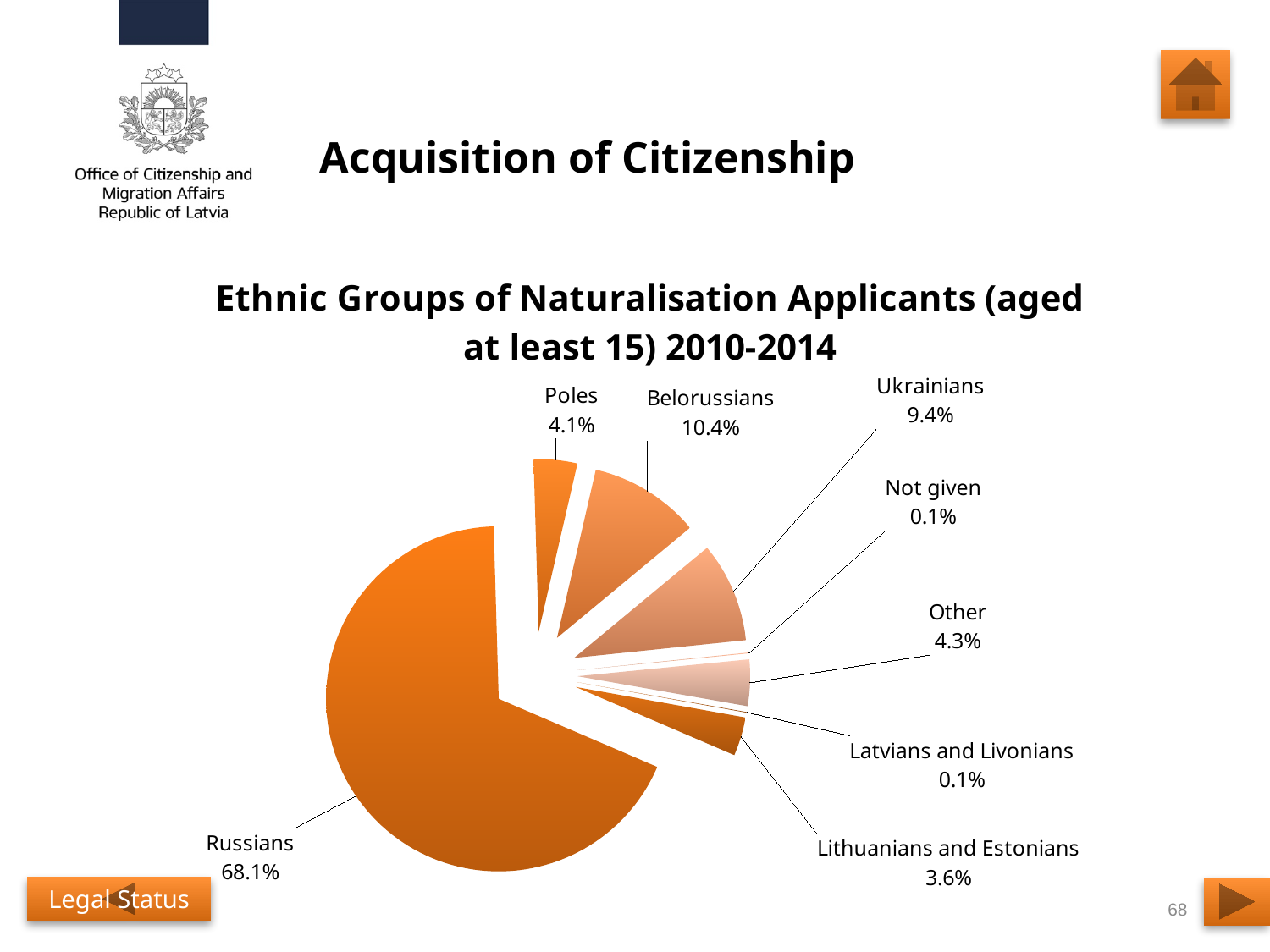
What percentage of applicants were Belorussians? 10.4% What kind of chart is shown on the slide? Pie chart How many ethnic group categories are shown in the pie chart? 8 What is the title of the chart? Ethnic Groups of Naturalisation Applicants (aged at least 15) 2010-2014 Which is larger, the share for Poles or the share for Other? Other What is the combined share of Poles and Belorussians? 14.5% What share of naturalisation applicants were Russians? 68.1% What share is shown for the 'Not given' category? 0.1% What share is shown for Ukrainians? 9.4% What percentage is shown for Lithuanians and Estonians? 3.6% Which ethnic group has the largest share of the pie? Russians What is the difference in percentage points between Belorussians and Ukrainians? 1.0%